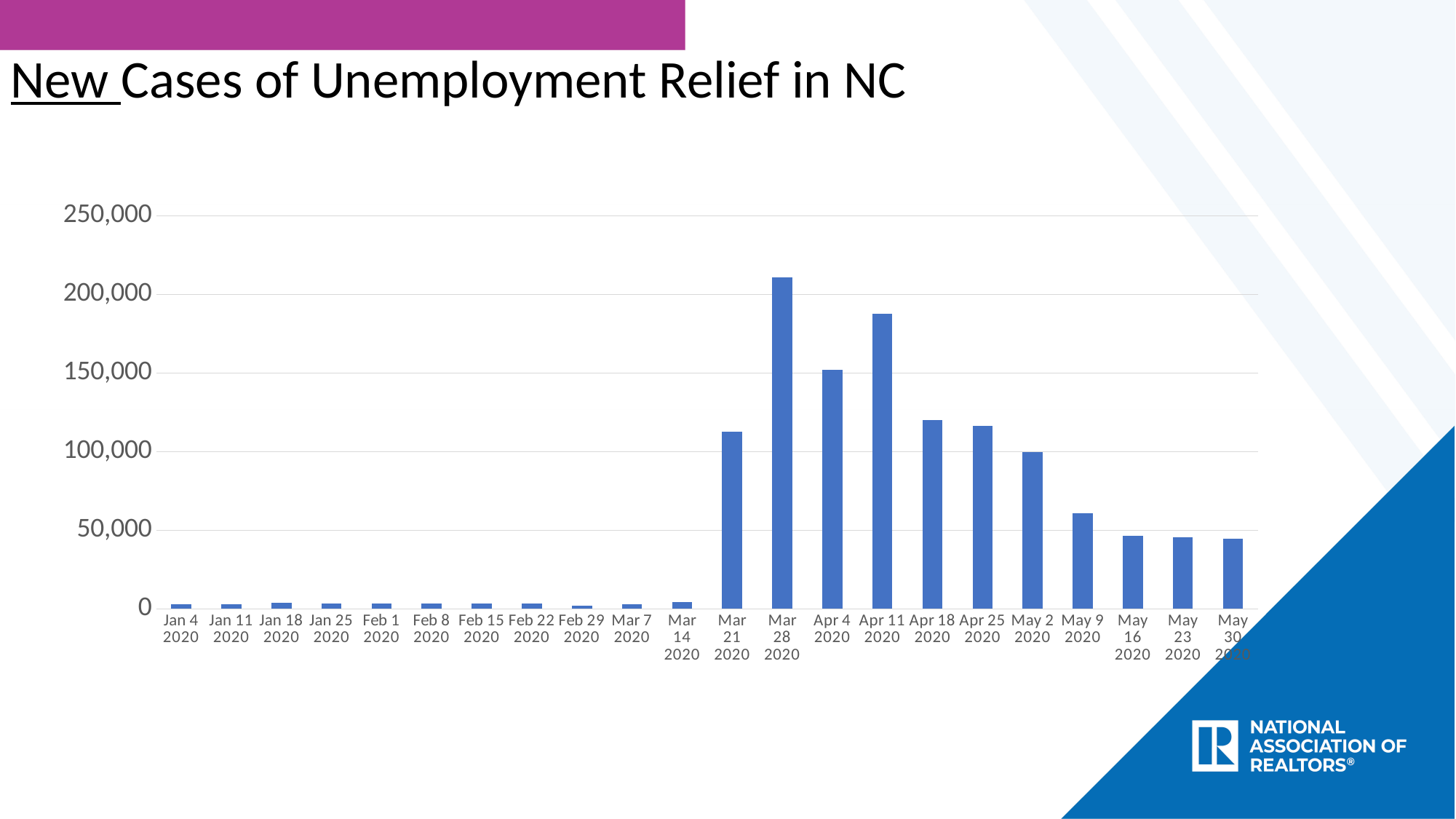
What kind of chart is shown on the slide? Bar chart Is the value for Apr 11 2020 greater or less than 200,000? less Is the value for May 9 2020 greater or less than 50,000? greater Which week has the highest number of new cases? Mar 28 2020 How many weekly categories are shown on the x axis? 22 Do the values rise or fall from Mar 28 2020 to May 30 2020? Fall Which is larger, the value for Apr 4 2020 or Apr 11 2020? Apr 11 2020 Is the value for Mar 28 2020 greater or less than 200,000? greater Which is larger, the value for Mar 28 2020 or Apr 11 2020? Mar 28 2020 What is the title of the chart? New Cases of Unemployment Relief in NC